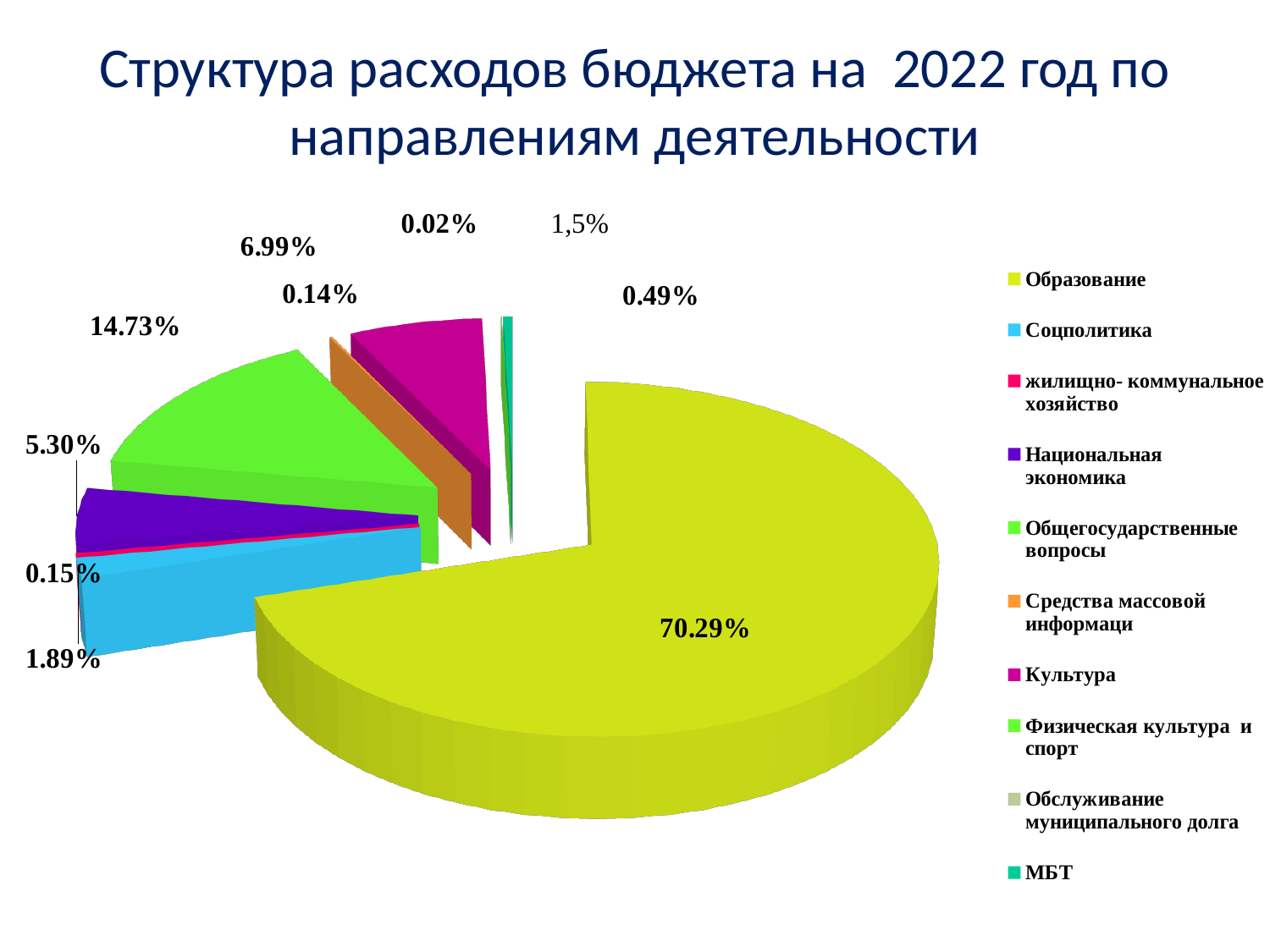
Which category has the largest slice of the pie chart? Образование What kind of chart is shown on the slide? Pie chart Which legend entry is shown in teal (the last entry in the legend)? МБТ Which is larger in the pie chart: the slice for Образование or the slice for Соцполитика? Образование How many categories does the legend of the pie chart list? 10 What is the title of the chart on the slide? Структура расходов бюджета на 2022 год по направлениям деятельности What share of the pie does Образование account for? 70.29%